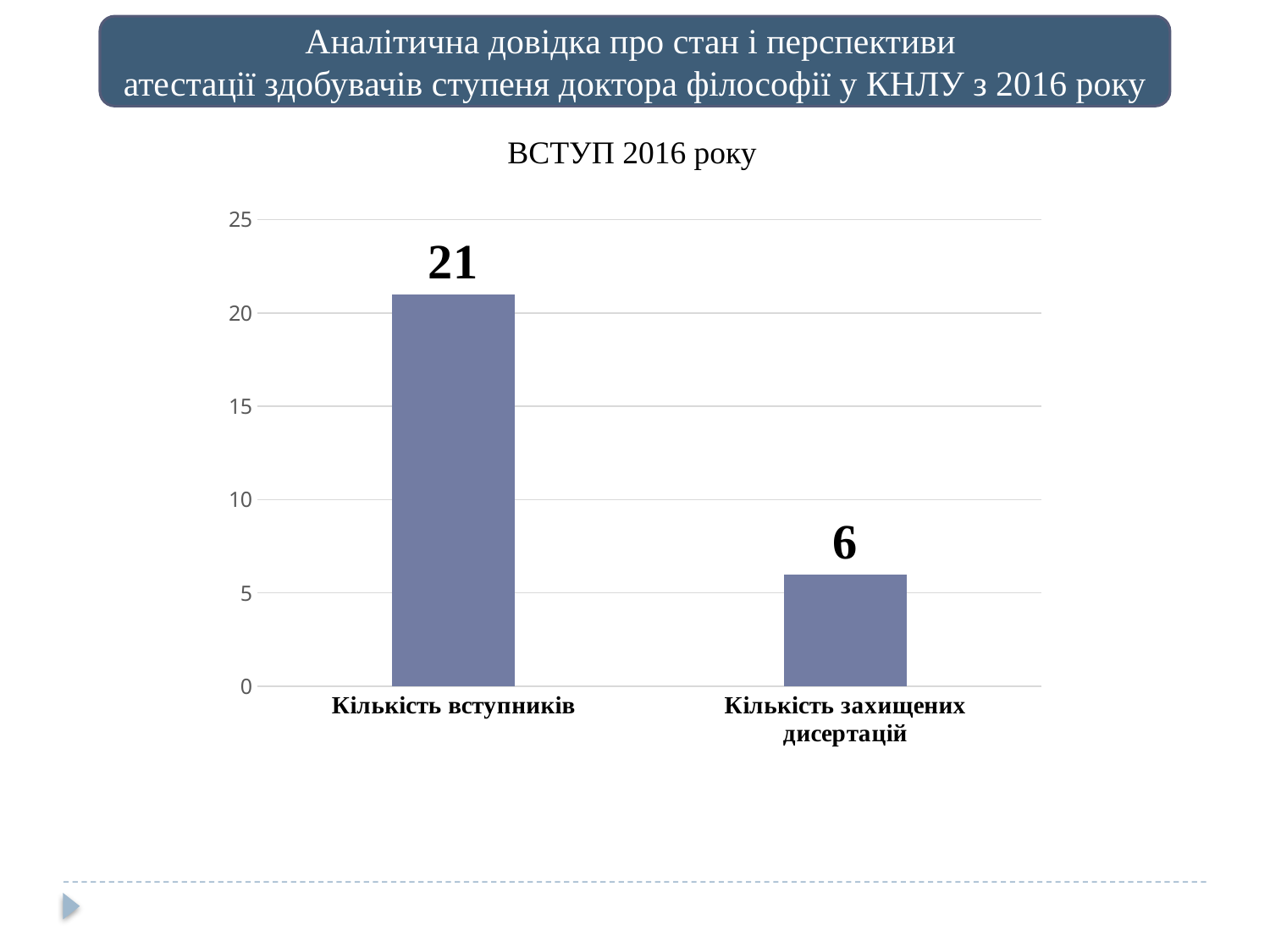
Which category has the lowest value? Кількість захищених дисертацій Which category has the highest value? Кількість вступників What is the title of the chart? ВСТУП 2016 року Which is larger, Кількість вступників or Кількість захищених дисертацій? Кількість вступників What is the highest value shown on the vertical axis? 25 What is the difference between Кількість вступників and Кількість захищених дисертацій? 15 How many categories are shown in the chart? 2 What is the value for Кількість вступників? 21 Is the value for Кількість вступників greater or less than 20? greater What kind of chart is shown on the slide? bar chart What is the value for Кількість захищених дисертацій? 6 Is the value for Кількість захищених дисертацій greater or less than 10? less